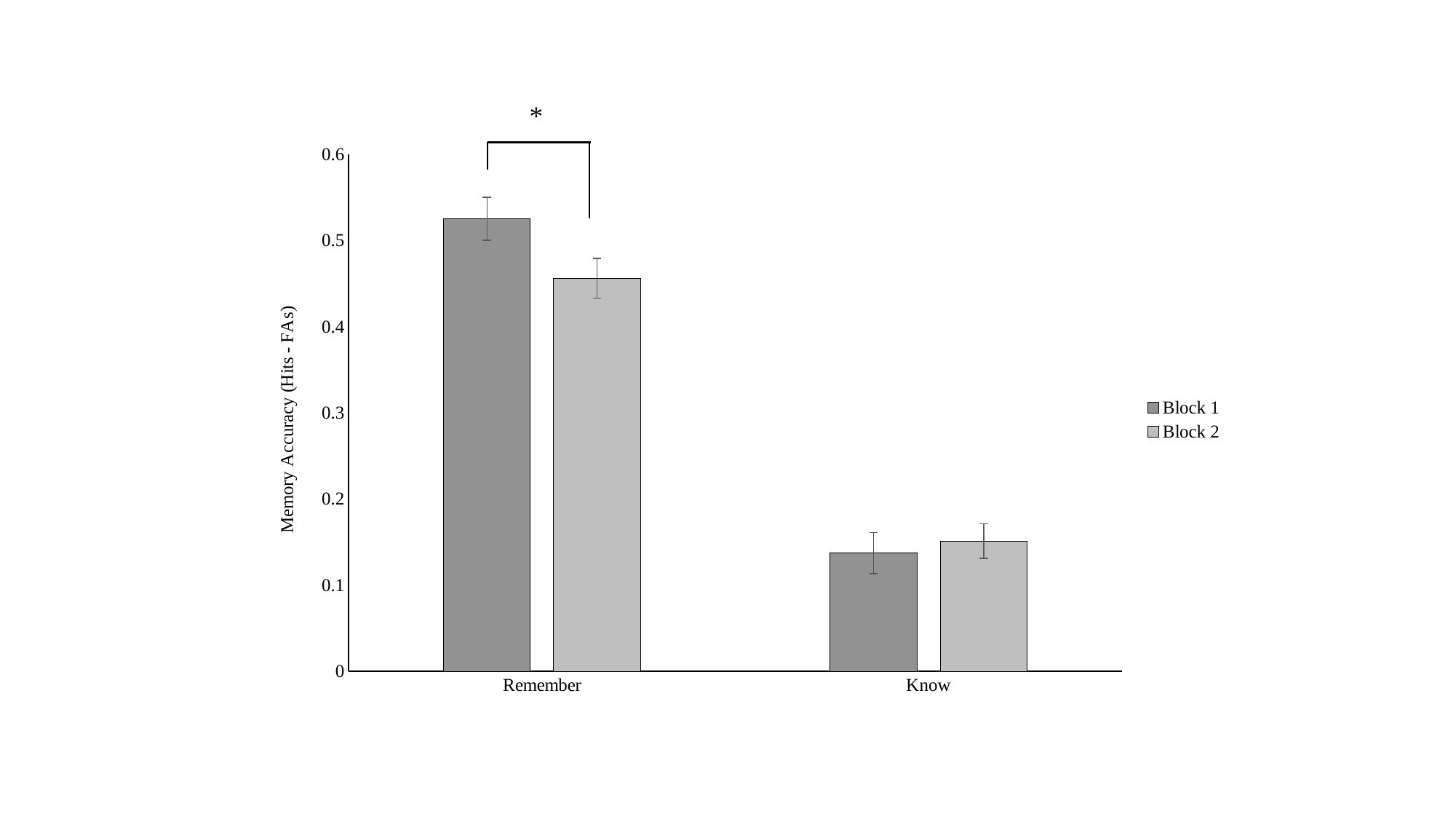
Is the Block 1 value for Know greater or less than 0.1? greater How many categories are shown on the x axis? 2 Is the Block 1 value for Remember greater or less than 0.5? greater What kind of chart is shown on the slide? bar chart How many series does the legend list? 2 Is the Block 2 value for Remember greater or less than 0.5? less Which category has the lower memory accuracy values overall, Remember or Know? Know For the Remember category, which is larger, Block 1 or Block 2? Block 1 Which category and series has the highest bar? Remember, Block 1 What is the label on the y axis? Memory Accuracy (Hits - FAs) What are the two entries listed in the legend? Block 1 and Block 2